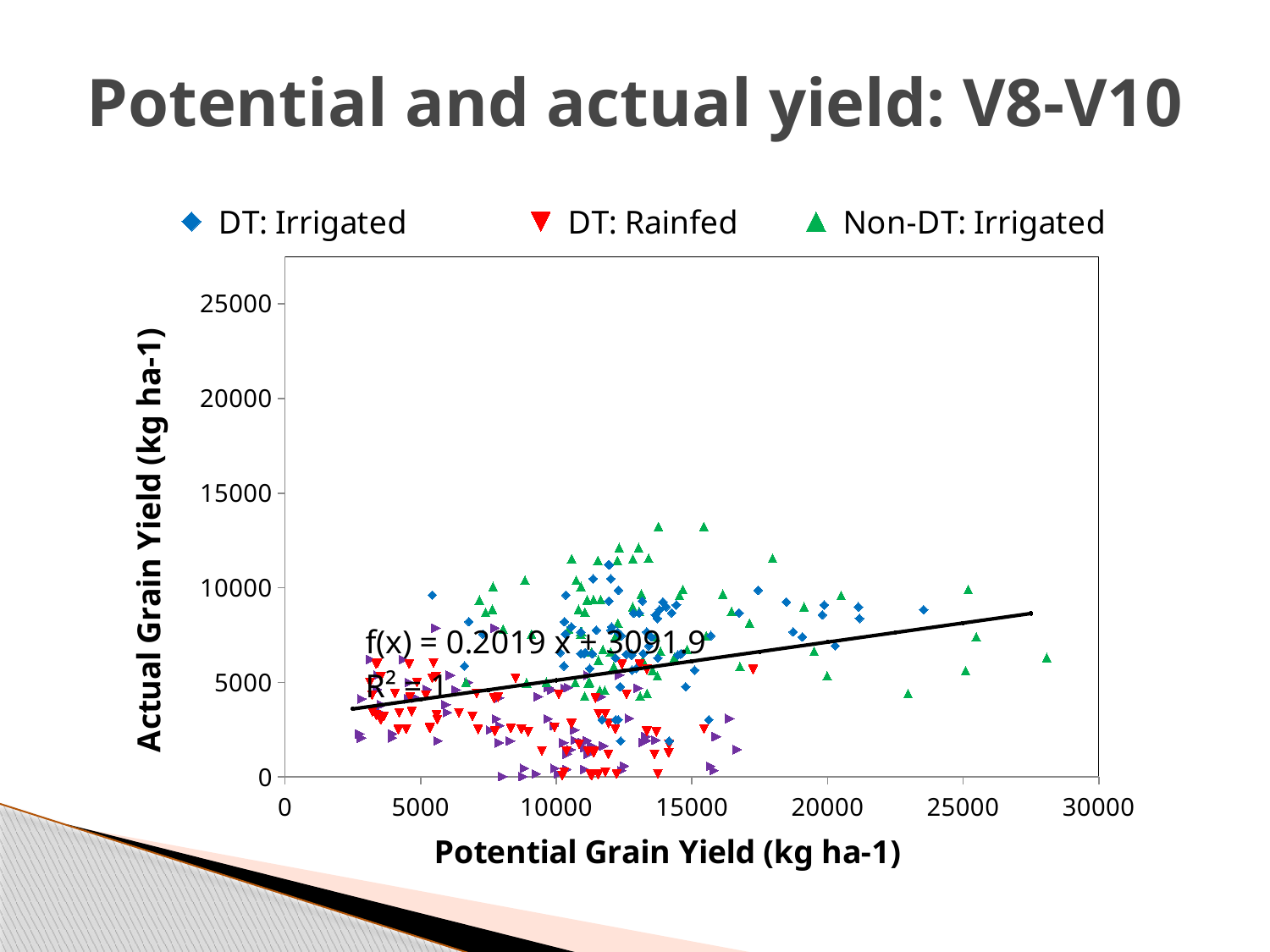
What is the label of the y axis? Actual Grain Yield (kg ha-1) What kind of chart is shown on the slide? Scatter chart How many series does the chart's legend list? 3 What is the highest tick value shown on the y axis? 25000 What is the equation of the trendline shown on the chart? f(x) = 0.2019 x + 3091.9 Which series is shown with green triangle markers? Non-DT: Irrigated Are the DT: Rainfed points mostly greater or less than 5000 on the Actual Grain Yield axis? less What R² value is printed on the chart? R² = 1 Does the trendline rise or fall as Potential Grain Yield increases? Rise What is the slope of the trendline equation shown on the chart? 0.2019